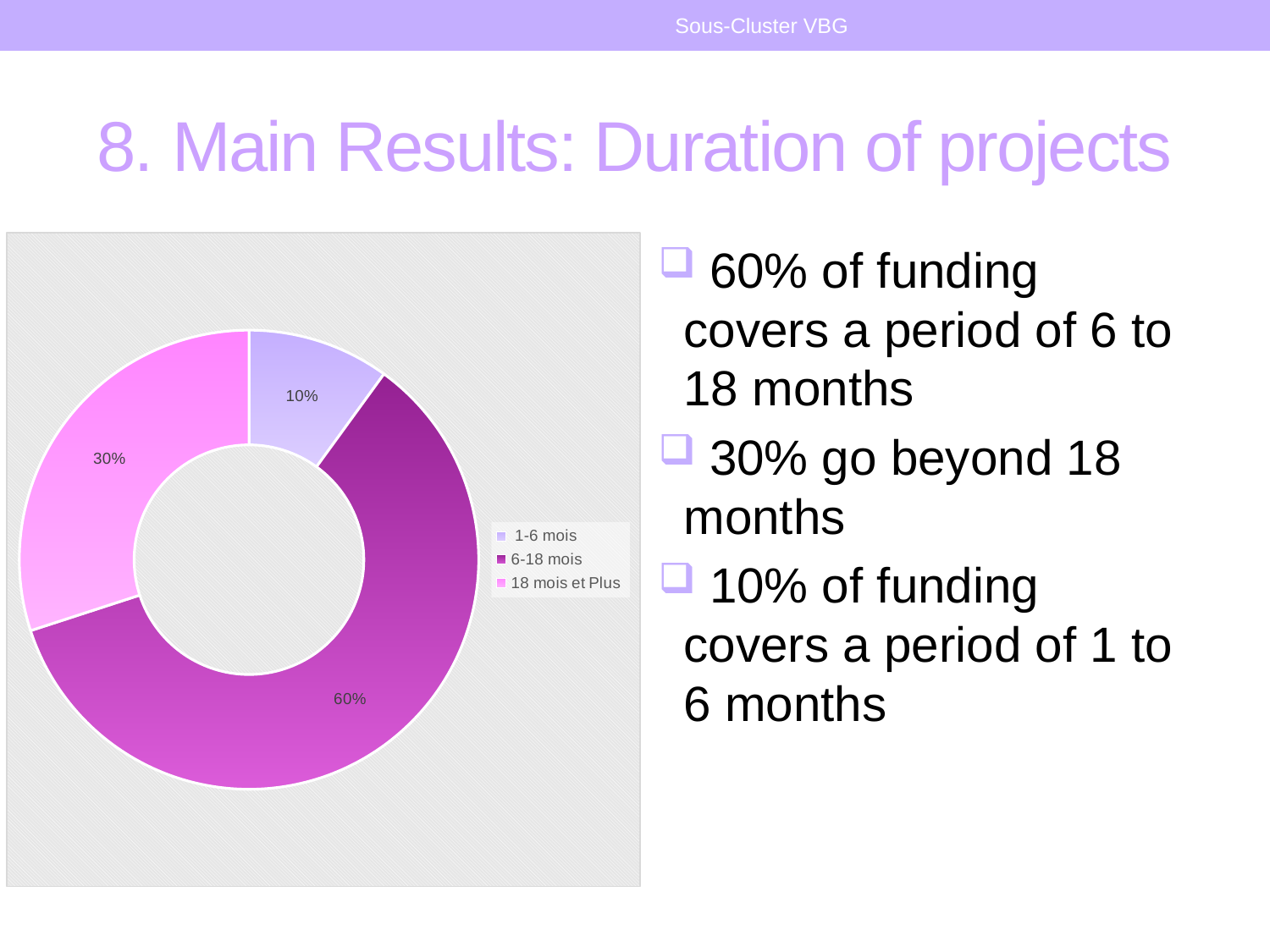
How many categories does the doughnut chart show? 3 Which is larger: the share for "18 mois et Plus" or the share for "1-6 mois"? 18 mois et Plus What is the difference in percentage points between the "18 mois et Plus" and "1-6 mois" shares? 20 What share of the doughnut chart does the "18 mois et Plus" category represent? 30% What share of the doughnut chart does the "6-18 mois" category represent? 60% Which category has the smallest share in the doughnut chart? 1-6 mois Which category has the largest share in the doughnut chart? 6-18 mois What share of the doughnut chart does the "1-6 mois" category represent? 10% What kind of chart is shown on the slide? Doughnut chart Which legend entry is shown in the darkest purple colour? 6-18 mois How many entries does the legend of the doughnut chart list? 3 What is the difference in percentage points between the "6-18 mois" and "18 mois et Plus" shares? 30